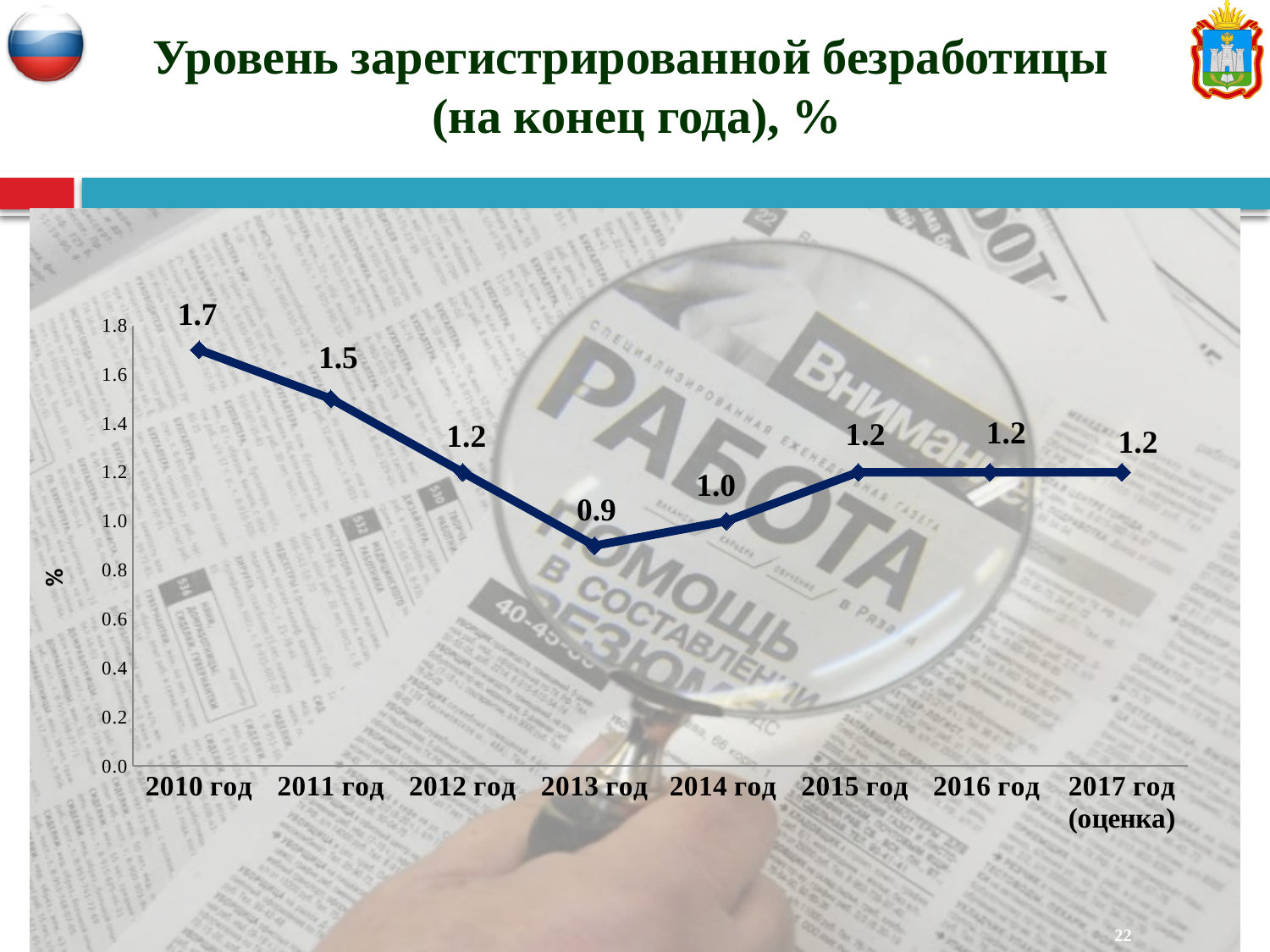
Which year has the lowest registered unemployment rate? 2013 год What kind of chart is shown on the slide? line chart What is the registered unemployment rate for 2010 год? 1.7 What is the difference between the values for 2011 год and 2012 год? 0.3 How many years are plotted on the chart? 8 Does the value rise or fall from 2010 год to 2013 год? fall What is the value shown for 2013 год? 0.9 What is the difference between the values for 2010 год and 2013 год? 0.8 Which year has the highest registered unemployment rate? 2010 год Which is larger, the value for 2011 год or the value for 2014 год? 2011 год What is the value shown for 2017 год (оценка)? 1.2 What is the title of the chart? Уровень зарегистрированной безработицы (на конец года), %